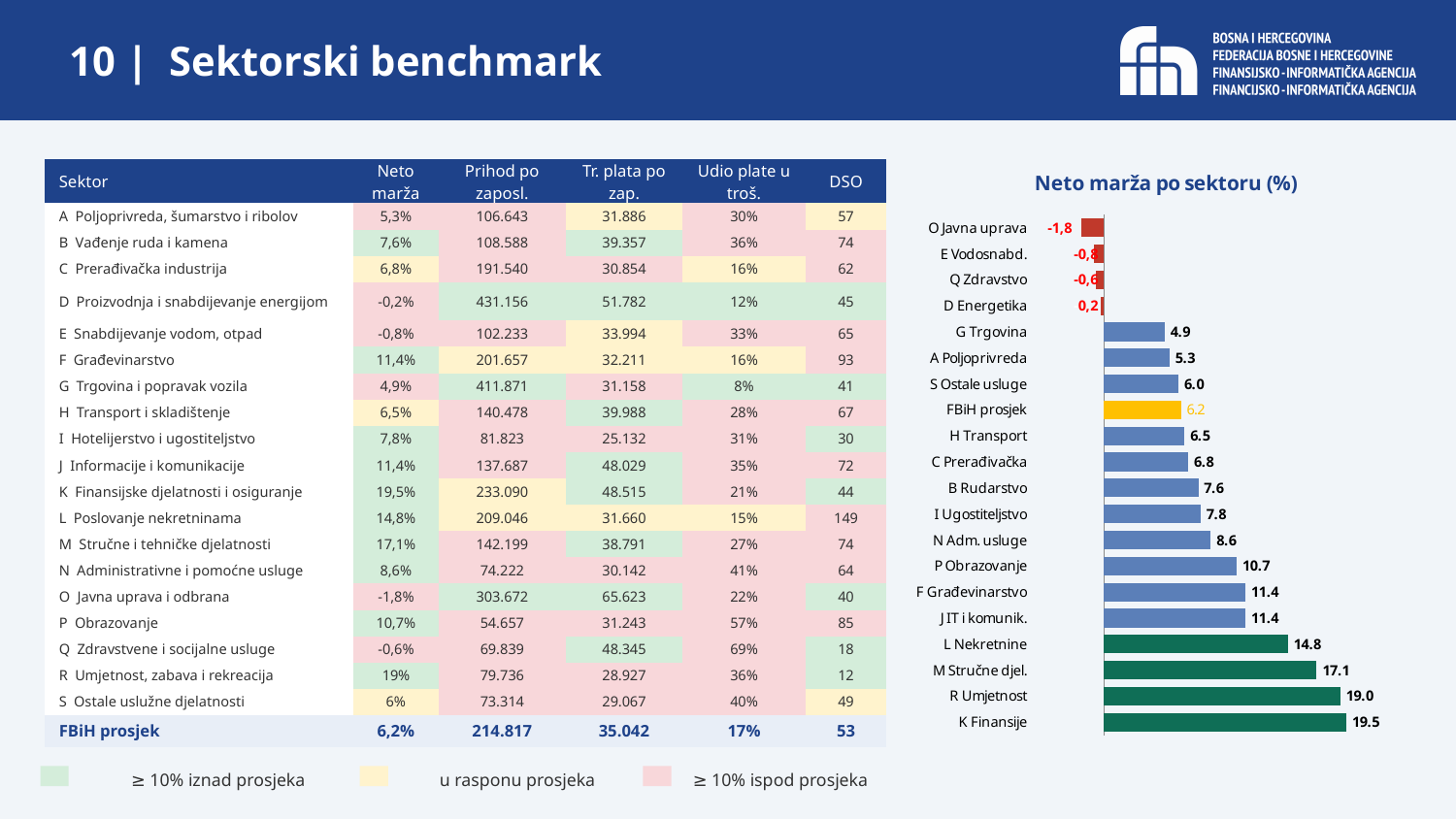
In the chart "Neto marža po sektoru (%)", what is the value for L Nekretnine? 14.8 What type of chart is shown under the title "Neto marža po sektoru (%)"? bar chart In the chart "Neto marža po sektoru (%)", what colour is the bar for FBiH prosjek? yellow In the chart "Neto marža po sektoru (%)", what is the value for K Finansije? 19.5 In the chart "Neto marža po sektoru (%)", which sector has the highest net margin? K Finansije How many sector bars (including FBiH prosjek) are shown in the chart "Neto marža po sektoru (%)"? 20 In the chart "Neto marža po sektoru (%)", what is the difference between the values for K Finansije and R Umjetnost? 0.5 In the chart "Neto marža po sektoru (%)", what is the value for FBiH prosjek? 6.2 In the chart "Neto marža po sektoru (%)", what is the difference between the values for M Stručne djel. and L Nekretnine? 2.3 In the chart "Neto marža po sektoru (%)", what is the value for O Javna uprava? -1,8 In the chart "Neto marža po sektoru (%)", which is larger, the value for P Obrazovanje or the value for N Adm. usluge? P Obrazovanje In the chart "Neto marža po sektoru (%)", which sector has the lowest net margin? O Javna uprava